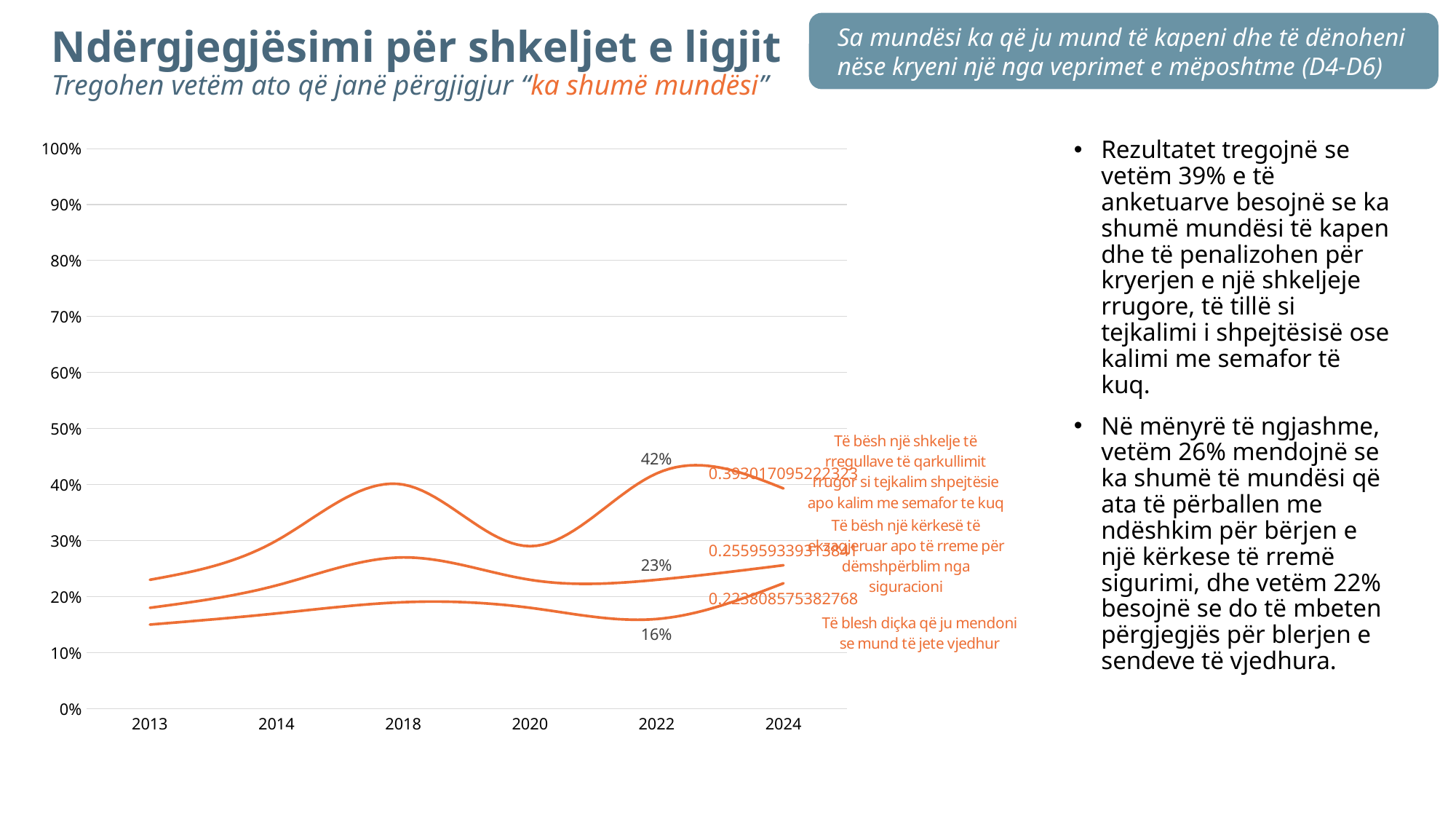
What is the value of the top line (traffic violation such as speeding or running a red light) in 2022? 42% Does the top line rise or fall between 2020 and 2022? rise What is the difference between the top line and the middle line in 2022? 19 percentage points Is the value of the bottom line in 2013 greater or less than 20%? less Which of the three lines has the highest value in 2022? Të bësh një shkelje të rregullave të qarkullimit rrugor si tejkalim shpejtësie apo kalim me semafor te kuq Is the value of the top line in 2013 greater or less than 20%? greater How many lines are plotted on the chart? 3 What is the value of the bottom line (buying something you think may be stolen) in 2022? 16% How many years are shown on the x axis of the chart? 6 What is the value of the middle line (exaggerated or false insurance claim) in 2022? 23% In 2022, which is larger: the value for the insurance claim line or the value for the stolen goods line? the insurance claim line (23%) What kind of chart is shown on the slide? line chart